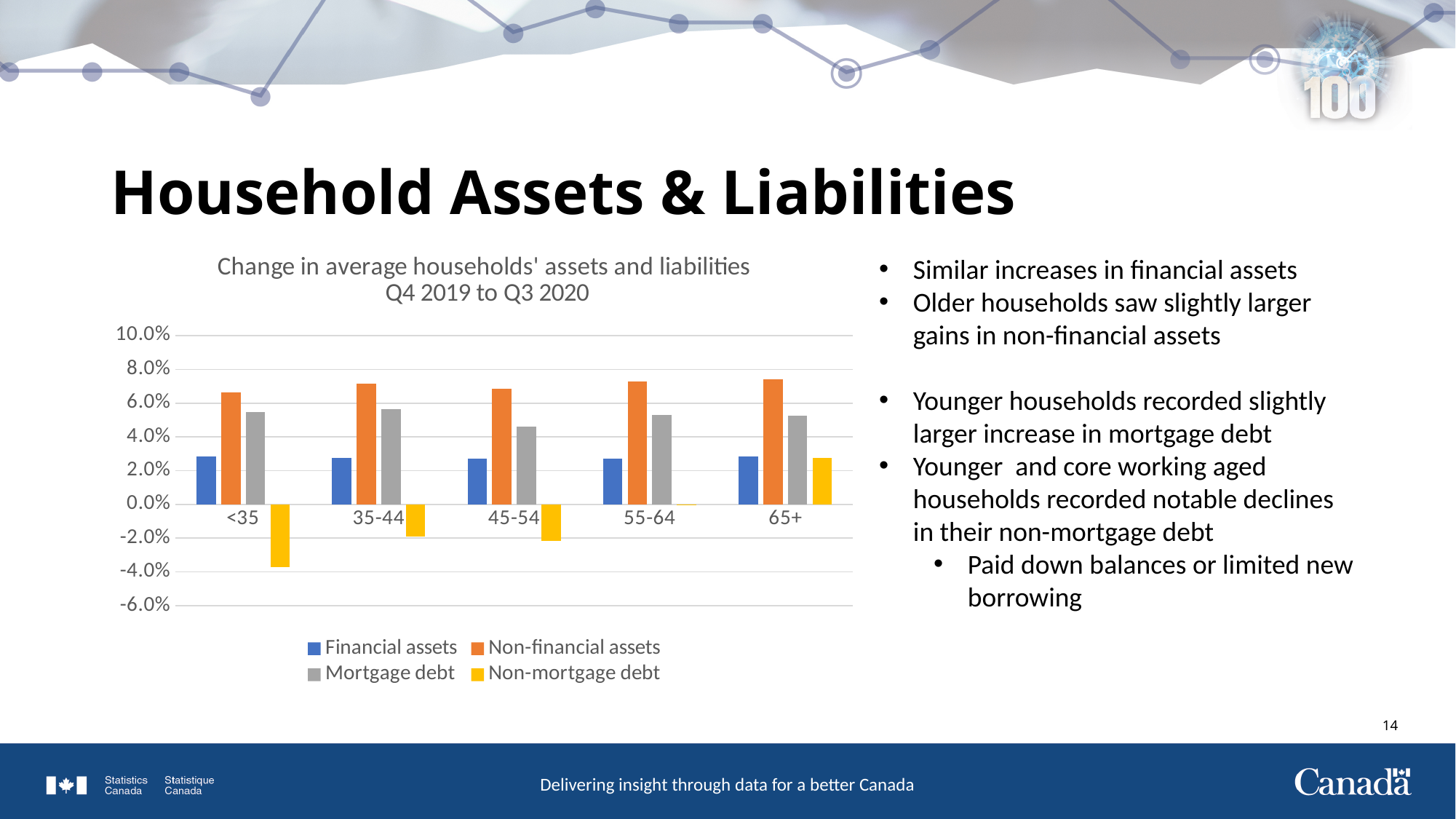
Which is larger: Non-mortgage debt for the 65+ group or for the <35 group? 65+ Which age group has the lowest value for Non-mortgage debt? <35 How many age groups are shown on the x axis of the chart? 5 Is the value for Non-mortgage debt for the 65+ group greater or less than 0.0%? greater What colour represents Non-mortgage debt in the chart? Yellow Is the value for Financial assets for the 65+ group greater or less than 4.0%? less Is the value for Non-mortgage debt for the <35 group greater or less than -2.0%? less For the 35-44 group, which is larger: Non-financial assets or Mortgage debt? Non-financial assets What kind of chart is shown on the slide? Bar chart Which age group has the lowest value for Mortgage debt? 45-54 How many series does the chart's legend list? 4